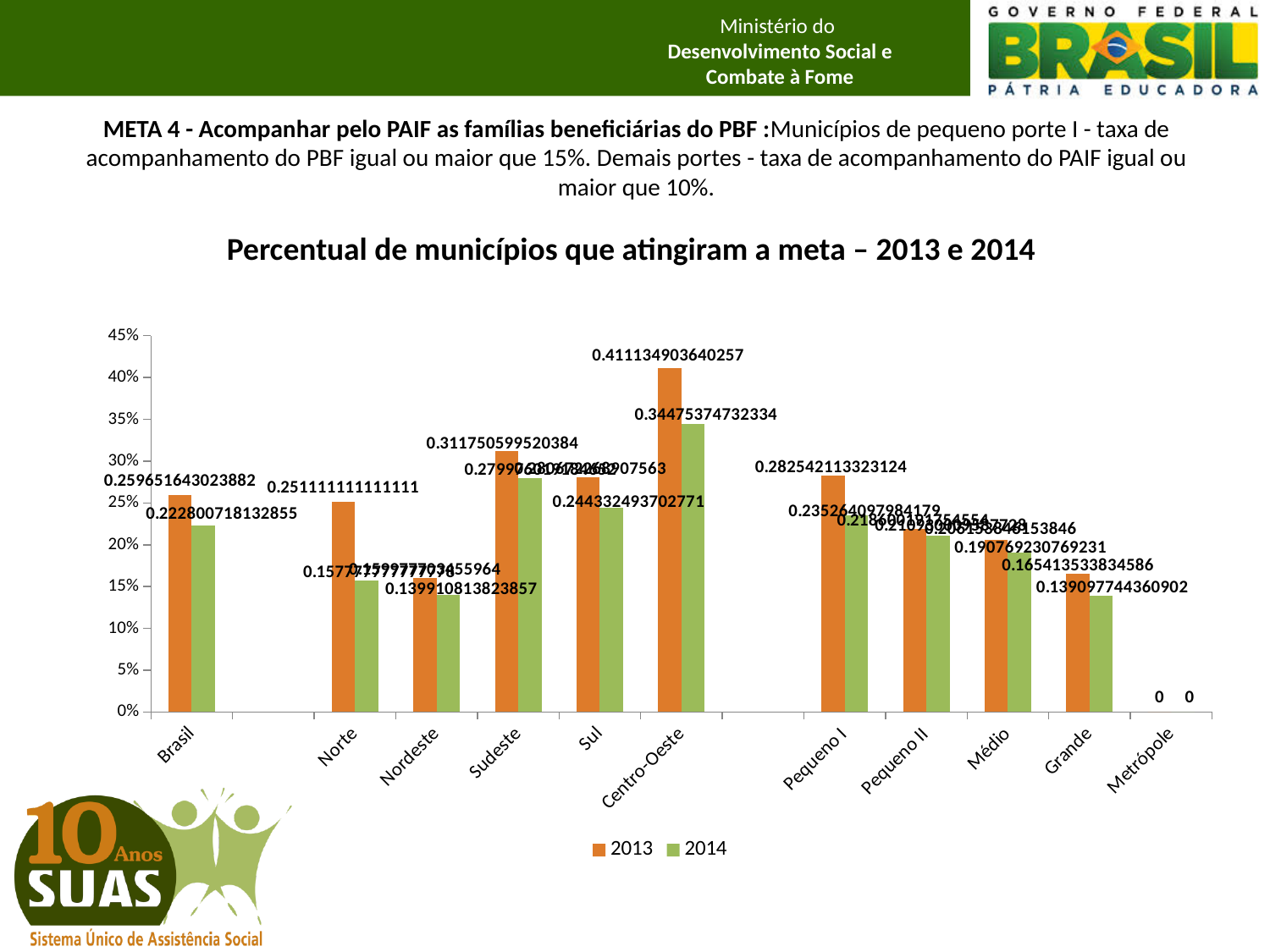
Which is larger for Pequeno I: the 2013 value or the 2014 value? 2013 How many series does the legend list? 2 Which category has the lowest value for 2014? Metrópole Which category has the highest value for 2013? Centro-Oeste What is the difference between the 2013 and 2014 values for Grande? 0.026315789473684 What is the value for Grande in 2014? 0.139097744360902 What is the value for Sudeste in 2013? 0.311750599520384 What is the value for Centro-Oeste in 2013? 0.411134903640257 What is the value for Brasil in 2014? 0.222800718132855 How many categories are shown on the x axis? 11 What kind of chart is shown on the slide? bar chart Is the value for Sul in 2013 greater or less than 25%? greater